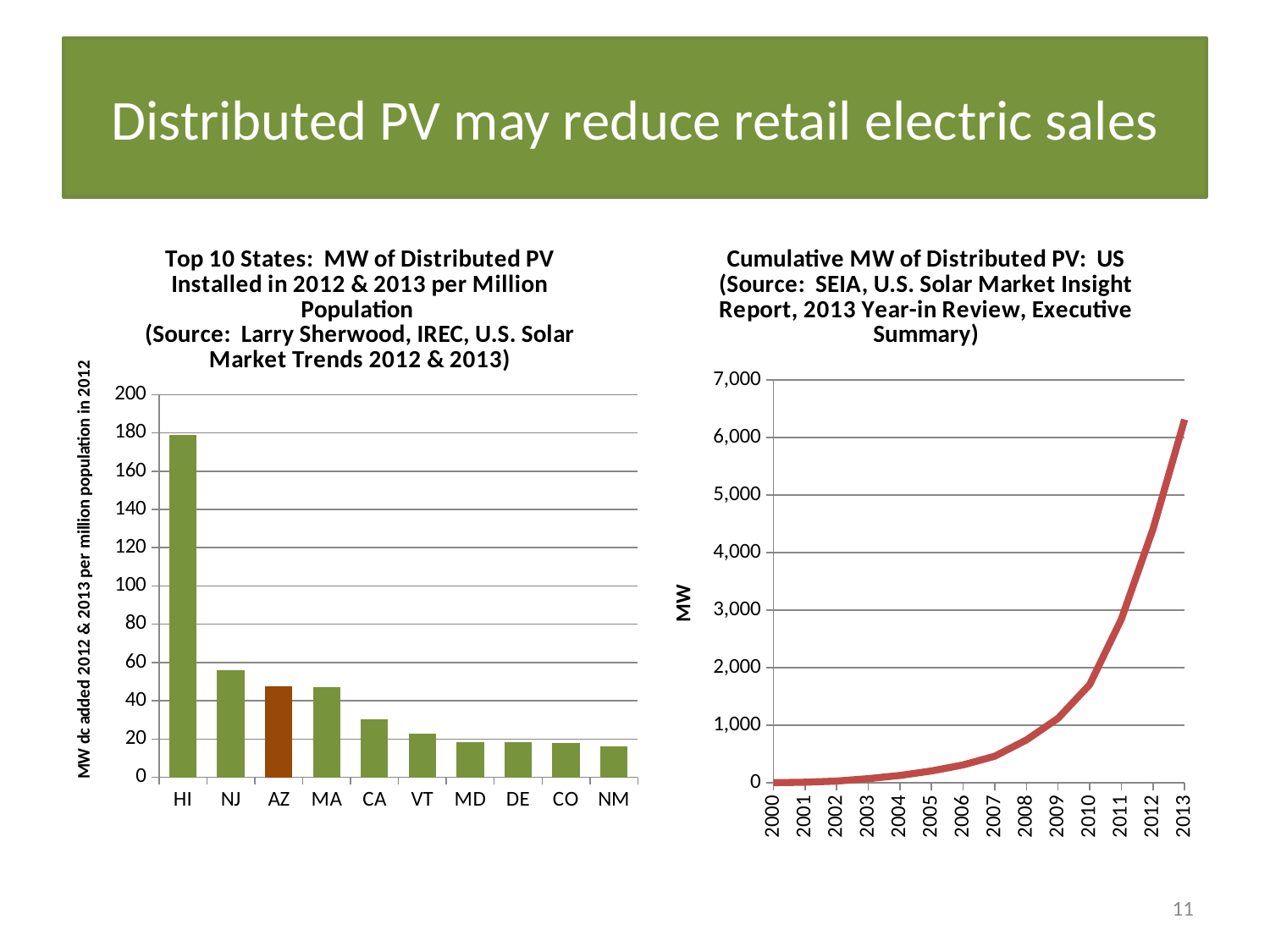
On the left chart (Top 10 States), which state has the highest value? HI On the right chart (Cumulative MW of Distributed PV: US), is the value for 2007 greater or less than 1,000? less On the left chart (Top 10 States), is the value for HI greater or less than 160? greater On the left chart (Top 10 States), how many states are shown? 10 On the left chart (Top 10 States), what kind of chart is it? bar chart On the left chart (Top 10 States), which is larger, the value for HI or the value for NJ? HI On the right chart (Cumulative MW of Distributed PV: US), do the values rise or fall from 2000 to 2013? rise On the left chart (Top 10 States), is the value for NJ greater or less than 40? greater On the left chart (Top 10 States), which is larger, the value for CA or the value for VT? CA On the left chart (Top 10 States), which state's bar is coloured differently from the others? AZ